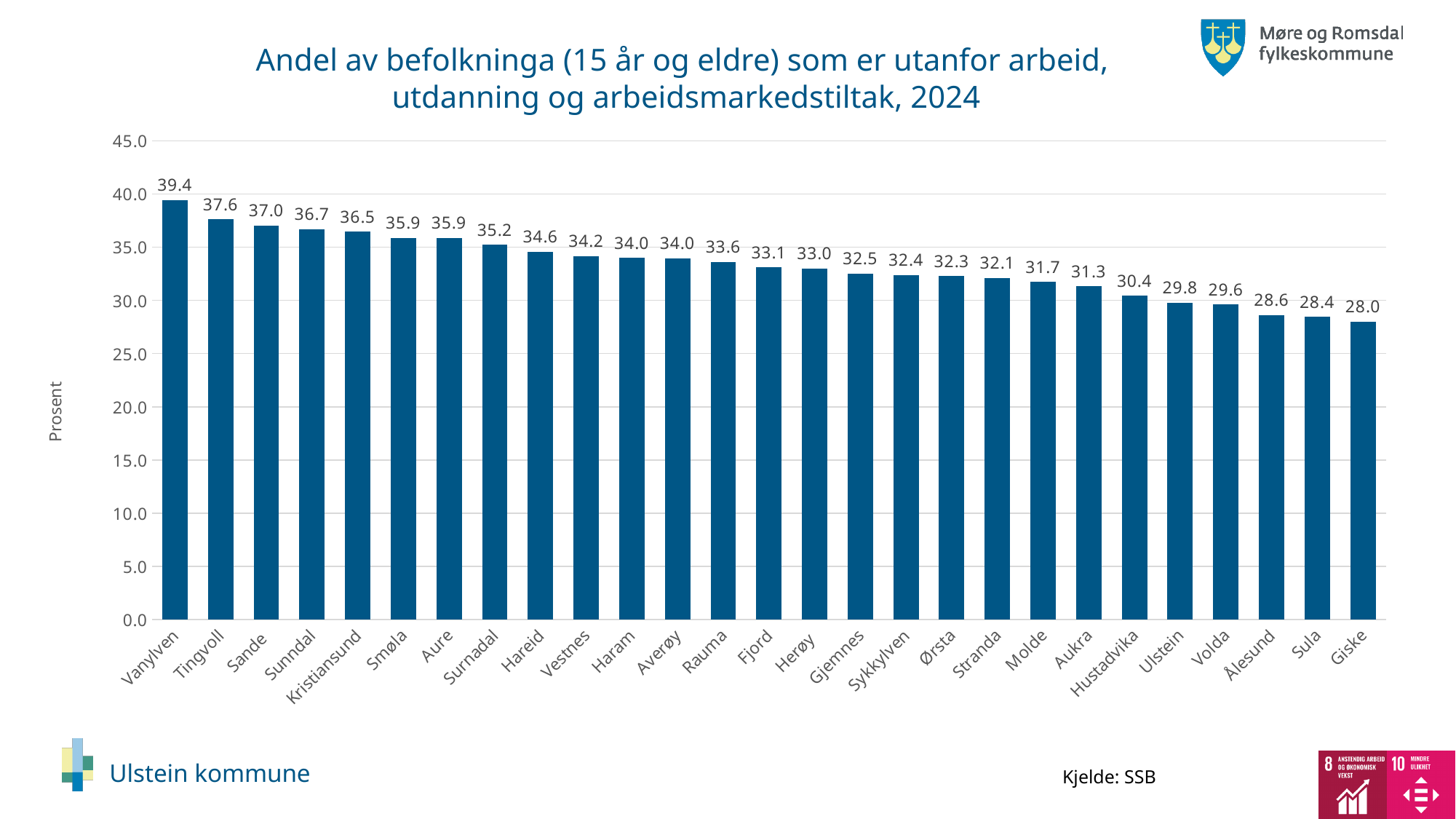
What is the difference between the values for Vanylven and Giske? 11.4 Is the value for Sula greater or less than 30.0? less Which municipality has the highest value? Vanylven What kind of chart is shown on the slide? bar chart Which municipality has the lowest value? Giske What is the value for Kristiansund? 36.5 What is the value for Ulstein? 29.8 How many municipalities are shown on the chart? 27 What is the label of the vertical axis? Prosent What is the difference between the values for Tingvoll and Ulstein? 7.8 Which has a larger value, Hareid or Volda? Hareid What is the value for Molde? 31.7